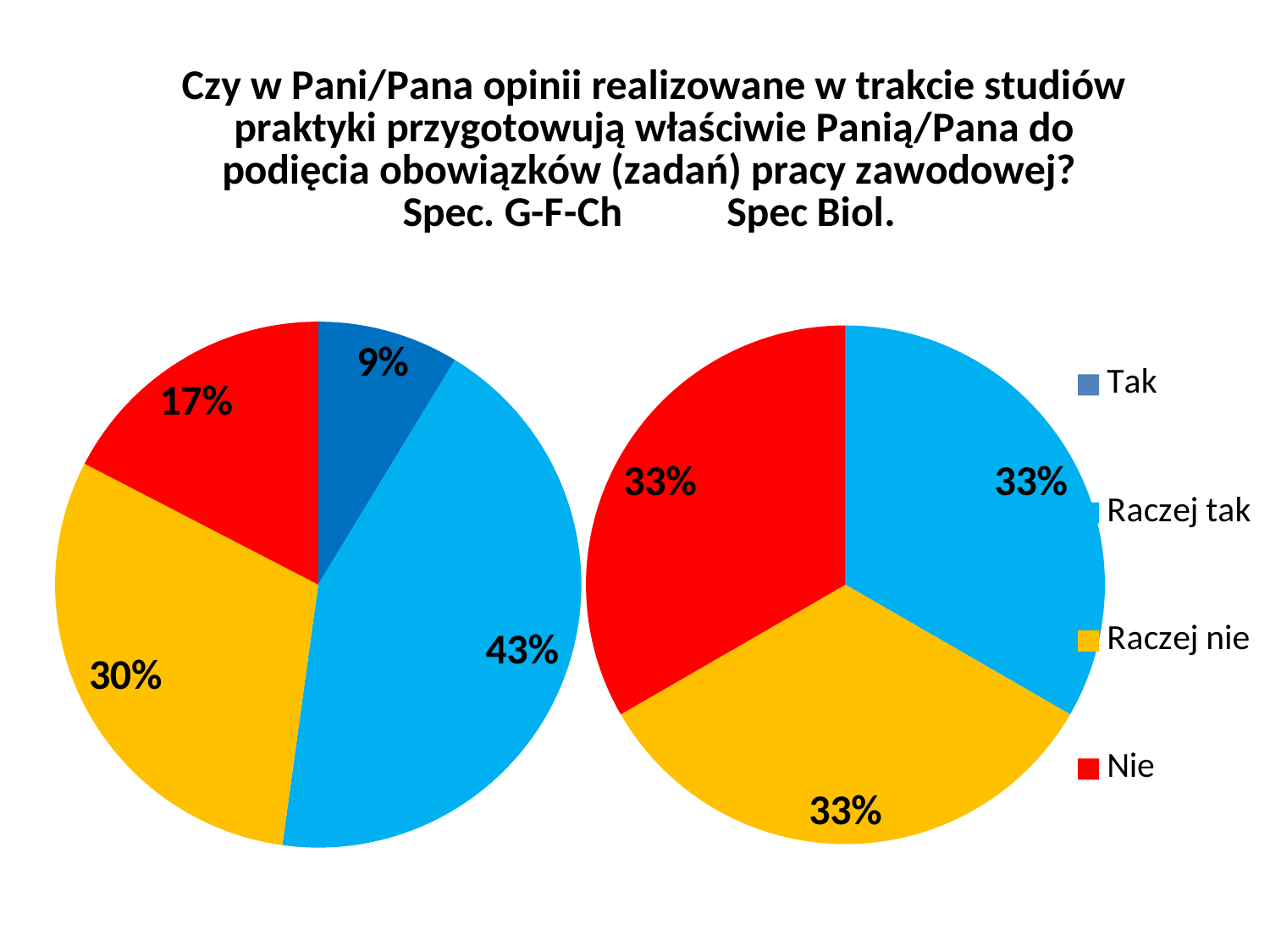
What kind of chart is used on this slide for Spec. G-F-Ch? Pie chart In the Spec. G-F-Ch pie chart, what is the difference in percentage points between "Raczej nie" and "Nie"? 13 percentage points In the Spec. G-F-Ch pie chart, what share of respondents answered "Tak"? 9% In the Spec. G-F-Ch pie chart, which answer has the largest share? Raczej tak How many slices does the Spec Biol. pie chart have? 3 In the Spec. G-F-Ch pie chart, which is larger: the share for "Raczej nie" or the share for "Nie"? Raczej nie In the Spec Biol. pie chart, what share of respondents answered "Nie"? 33% Which colour represents "Raczej nie" in the legend? Yellow How many entries does the legend list? 4 In the Spec. G-F-Ch pie chart, what share of respondents answered "Raczej tak"? 43% In the Spec. G-F-Ch pie chart, what share of respondents answered "Nie"? 17% In the Spec. G-F-Ch pie chart, which answer has the smallest share? Tak